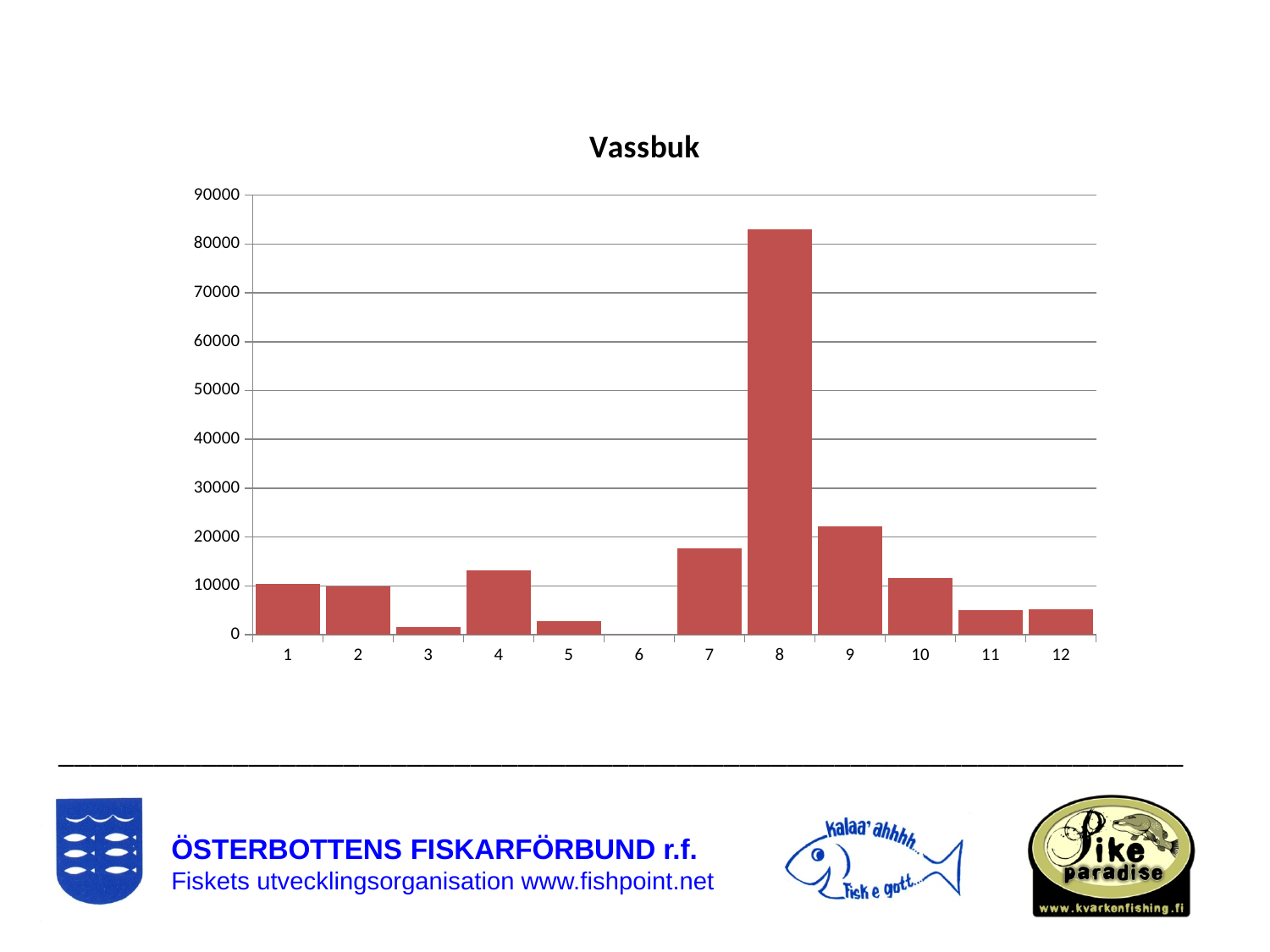
Which has the larger value, category 4 or category 5? 4 Is the value for category 8 greater or less than 80000? greater Which has the larger value, category 9 or category 7? 9 Which category has the lowest value in the chart? 6 How many categories are shown on the x axis of the chart? 12 What kind of chart is shown on the slide? bar chart What is the title of the chart? Vassbuk Which category has the highest value in the chart? 8 Is the value for category 4 greater or less than 10000? greater Is the value for category 9 greater or less than 20000? greater